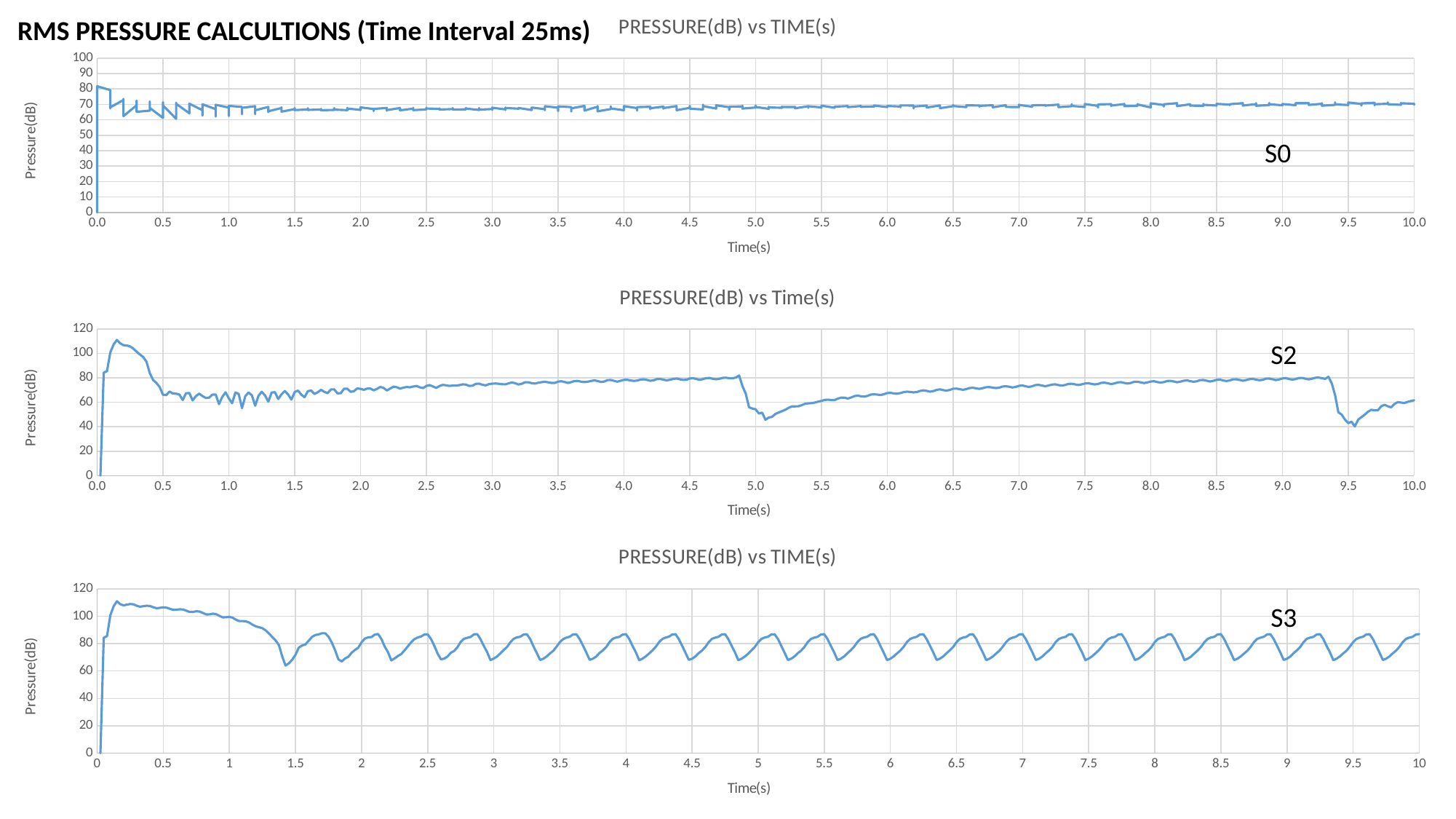
In the middle chart (S2), is the pressure value at 4.5 s greater or less than 60? greater In the middle chart (S2), does the pressure rise or fall between 5.5 s and 9.0 s? rise What is the highest value shown on the y axis of the top chart (S0)? 100 In the bottom chart (S3), is the pressure value at 1.0 s greater or less than 80? greater In the middle chart (S2), is the pressure value at 9.5 s greater or less than 60? less What kind of chart is the top chart labelled S0? Line chart How many charts are shown on the slide? 3 In the bottom chart (S3), does the pressure rise or fall between 0.5 s and 1.4 s? fall